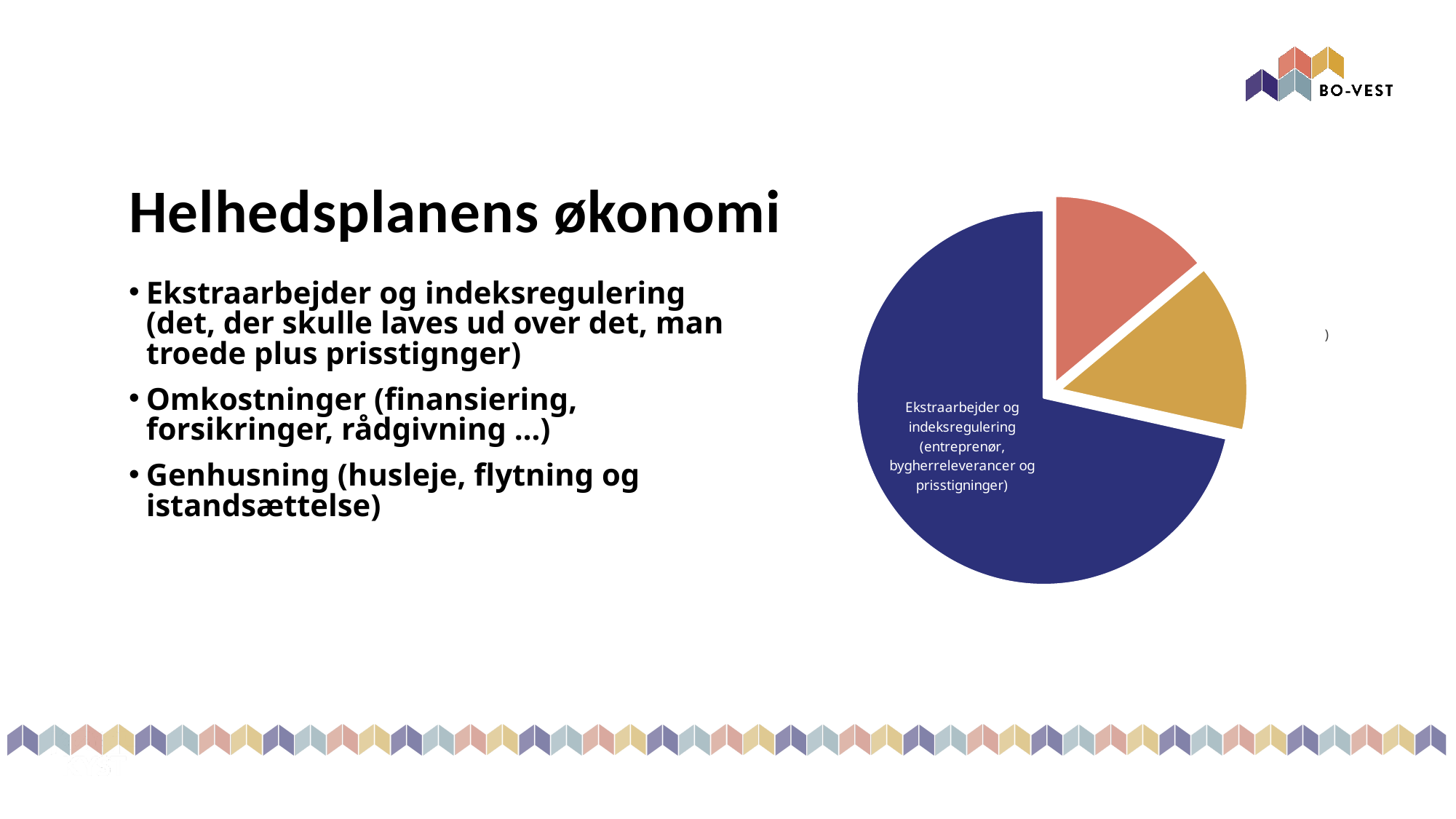
What colour is the largest slice of the pie chart? dark blue Which slice of the pie chart is the largest? Ekstraarbejder og indeksregulering (entreprenør, bygherreleverancer og prisstigninger) What kind of chart is shown on the slide? pie chart Which slice of the pie chart carries a text label? Ekstraarbejder og indeksregulering (entreprenør, bygherreleverancer og prisstigninger) How many slices does the pie chart have? 3